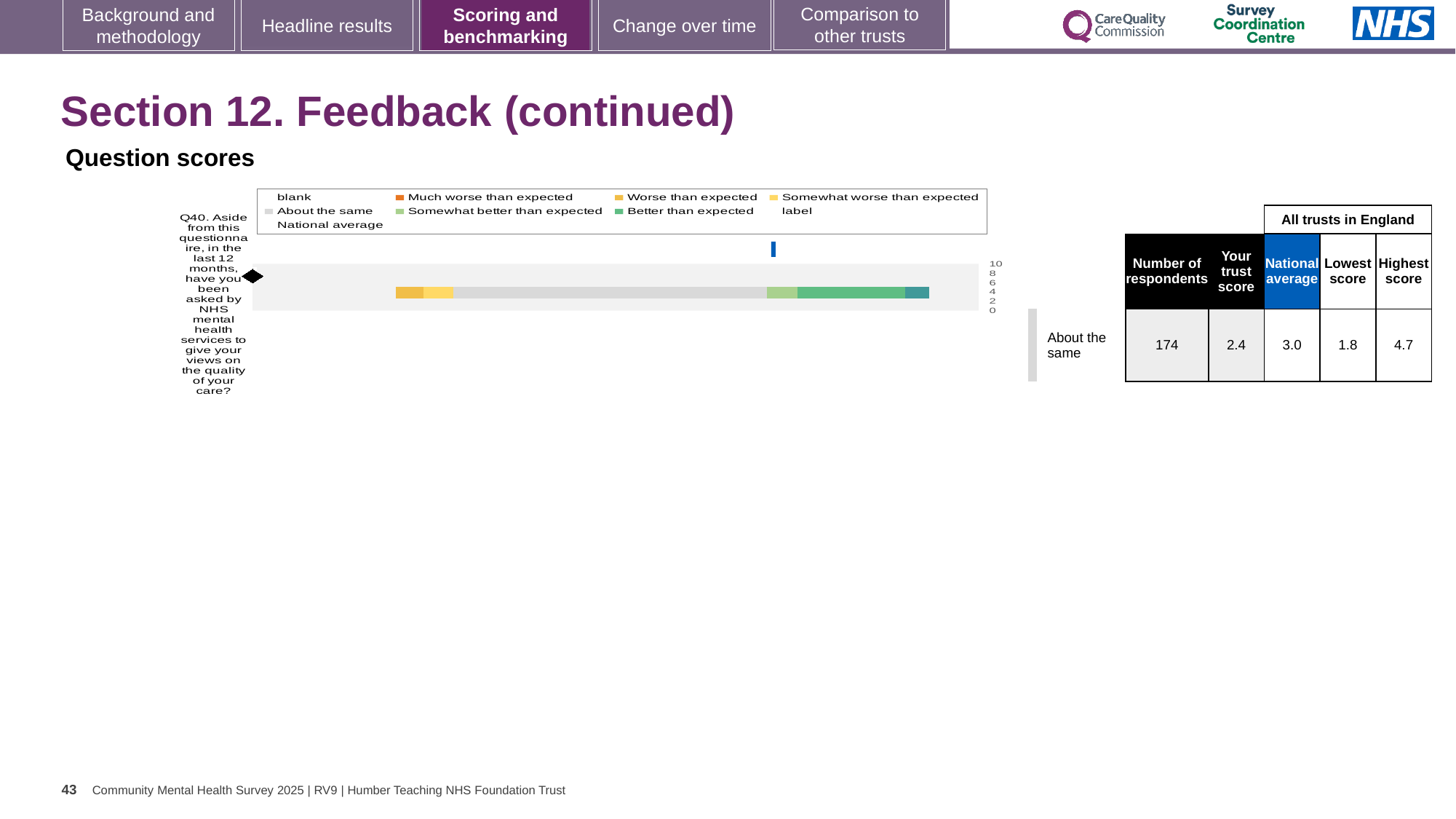
According to the table next to the chart, how many respondents answered Q40? 174 What benchmark category is shown for Q40 beside the chart? About the same How many questions (categories) are plotted in the chart? 1 What is the difference between the highest score and the lowest score for Q40 in the table? 2.9 According to the table next to the chart, what is the lowest score among all trusts in England for Q40? 1.8 Which question number is plotted in the chart? Q40 Which is larger for Q40, the trust score or the national average? national average What kind of chart is shown on the slide for Q40? bar chart According to the table next to the chart, what is the highest score among all trusts in England for Q40? 4.7 According to the table next to the chart, what is the trust score for Q40? 2.4 What colour does the legend use for 'Better than expected'? green According to the table next to the chart, what is the national average for Q40? 3.0